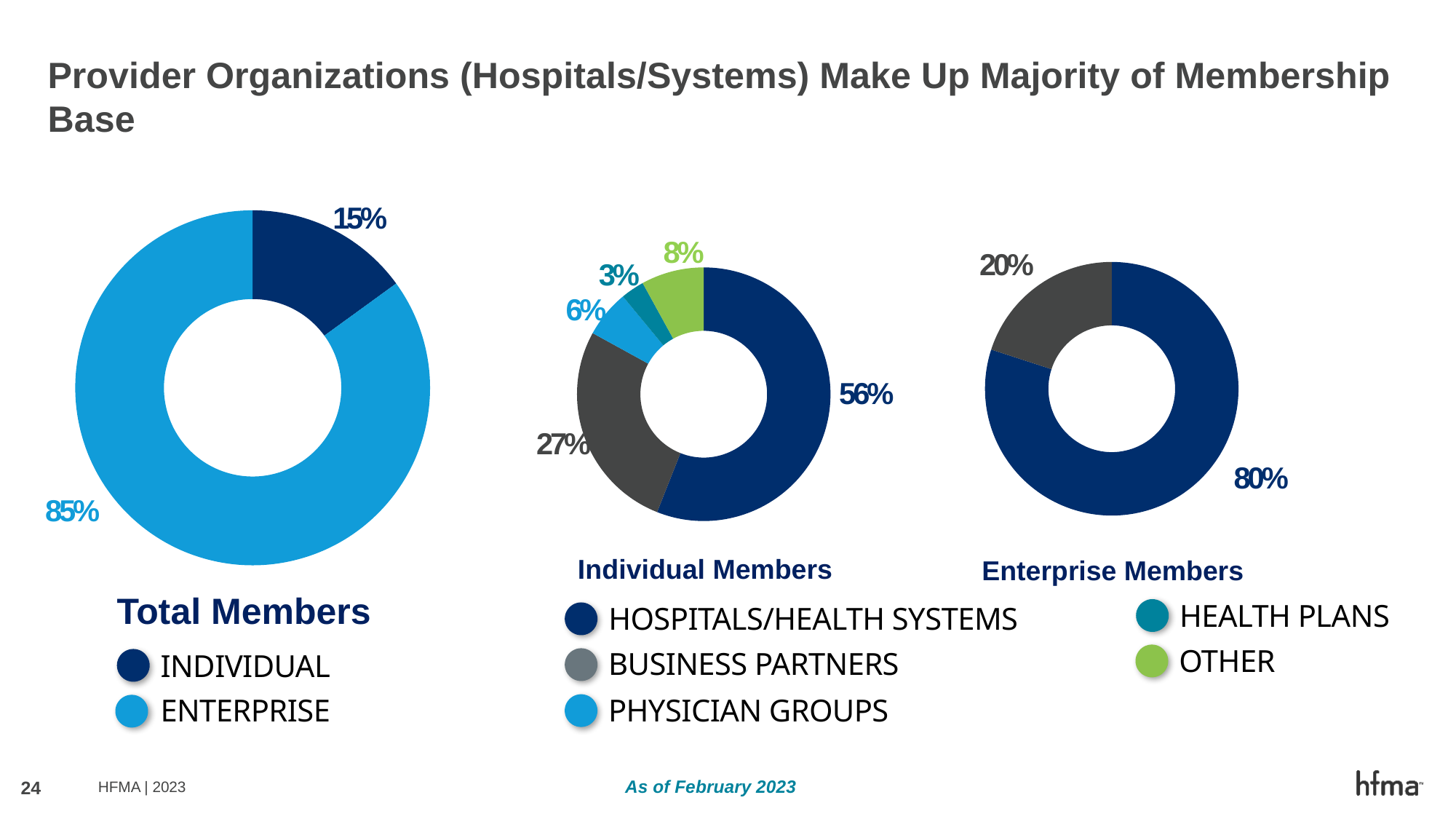
In the Individual Members chart, what percentage is Hospitals/Health Systems? 56% In the Total Members chart, what share of members are Enterprise? 85% In the Individual Members chart, what percentage is Other? 8% What type of chart is the Total Members chart? Donut chart In the Individual Members chart, which is larger: Physician Groups or Other? Other In the Total Members chart, what share of members are Individual? 15% In the Enterprise Members chart, what percentage is Business Partners? 20% In the Individual Members chart, what is the difference between the Hospitals/Health Systems share and the Business Partners share? 29% In the Individual Members chart, which category has the smallest share? Health Plans In the Individual Members chart, what percentage is Business Partners? 27% How many slices does the Individual Members chart have? 5 In the Enterprise Members chart, what percentage is Hospitals/Health Systems? 80%